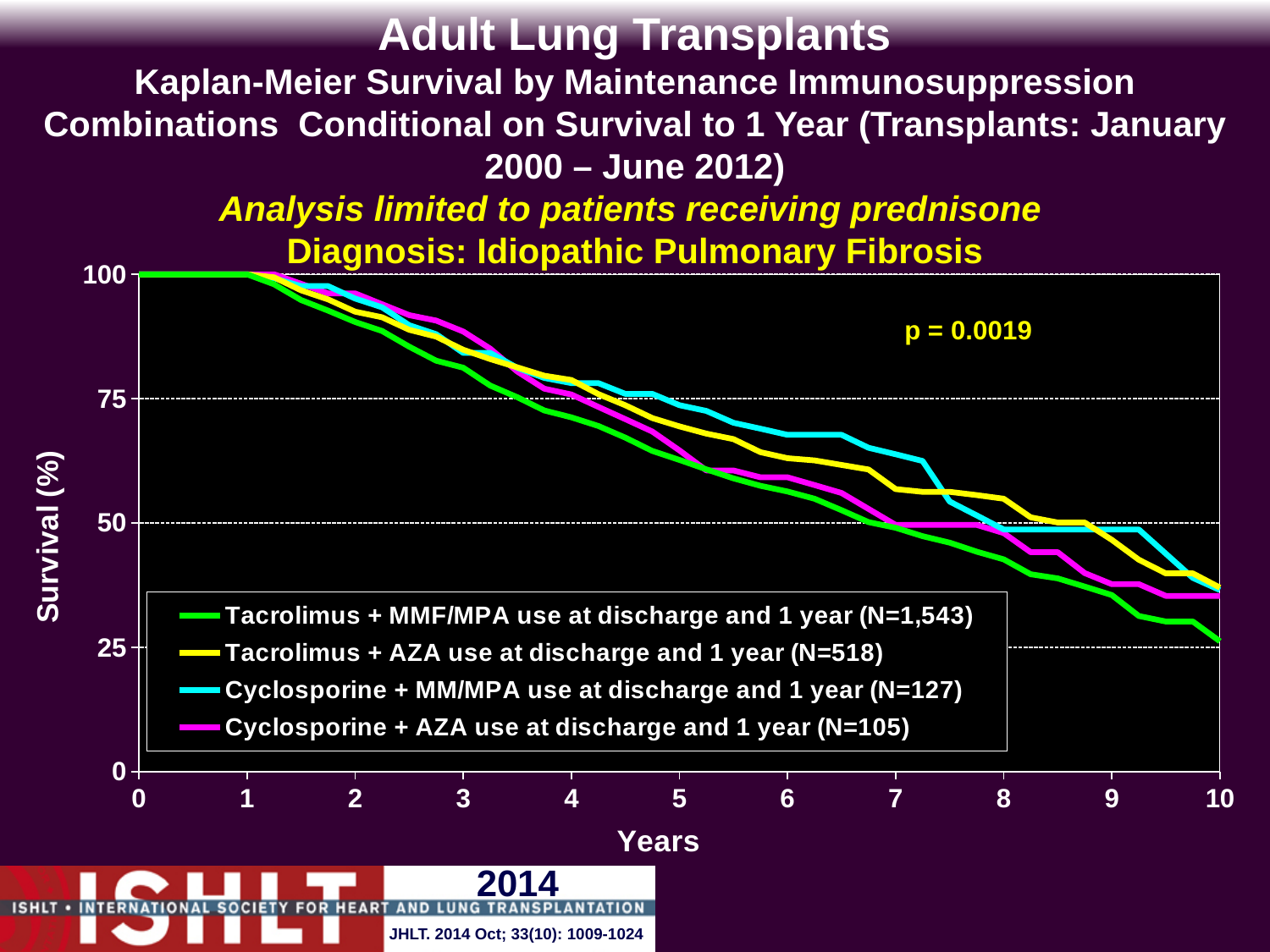
What p-value is printed on the chart? p = 0.0019 Is the survival for Tacrolimus + MMF/MPA at year 5 greater or less than 75? less What kind of chart is shown on the slide? line chart Is the survival for Tacrolimus + MMF/MPA at year 10 greater or less than 50? less Do the survival curves rise or fall as years increase? fall Which group has the lowest survival at year 10? Tacrolimus + MMF/MPA use at discharge and 1 year Is the survival for Cyclosporine + MM/MPA at year 10 greater or less than 50? less What is the N for the Tacrolimus + MMF/MPA group in the legend? N=1,543 How many series does the legend list? 4 What is the survival (%) for all groups at year 0? 100 At year 6, which has higher survival: Cyclosporine + MM/MPA or Tacrolimus + MMF/MPA? Cyclosporine + MM/MPA